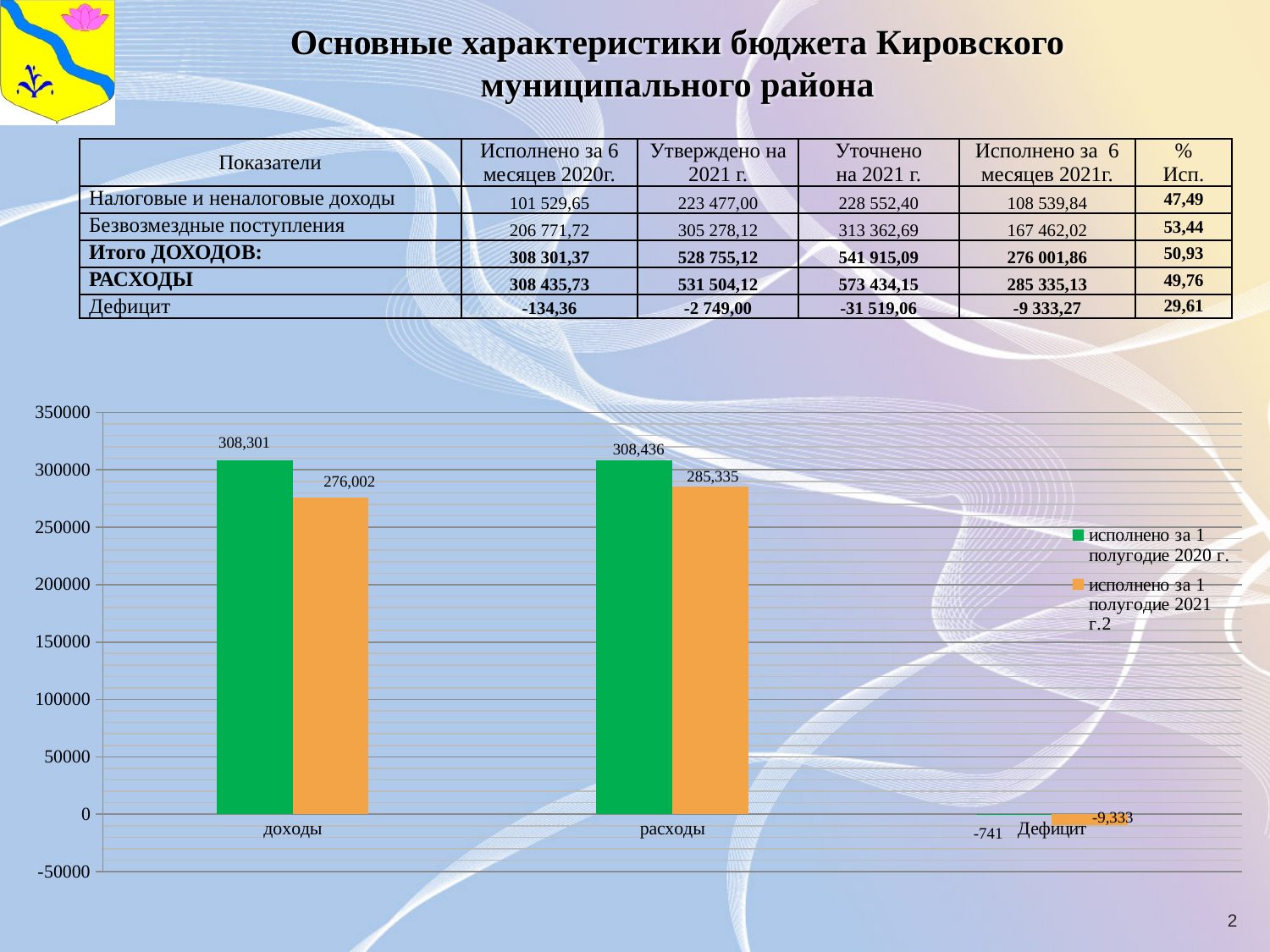
Which category has the lowest value in the series 'исполнено за 1 полугодие 2020 г.'? Дефицит Which is larger for доходы: the 2020 value or the 2021 value? 2020 value (308,301) What is the difference between the расходы and доходы values in the series 'исполнено за 1 полугодие 2021 г.2'? 9,333 What is the value for расходы in the series 'исполнено за 1 полугодие 2021 г.2'? 285,335 What kind of chart is shown on the slide? bar chart What is the value for Дефицит in the series 'исполнено за 1 полугодие 2021 г.2'? -9,333 How many series does the chart legend list? 2 What is the value for доходы in the series 'исполнено за 1 полугодие 2020 г.'? 308,301 Which colour represents the series 'исполнено за 1 полугодие 2021 г.2'? orange What is the value for расходы in the series 'исполнено за 1 полугодие 2020 г.'? 308,436 How many categories are shown on the x axis of the chart? 3 What is the value for доходы in the series 'исполнено за 1 полугодие 2021 г.2'? 276,002